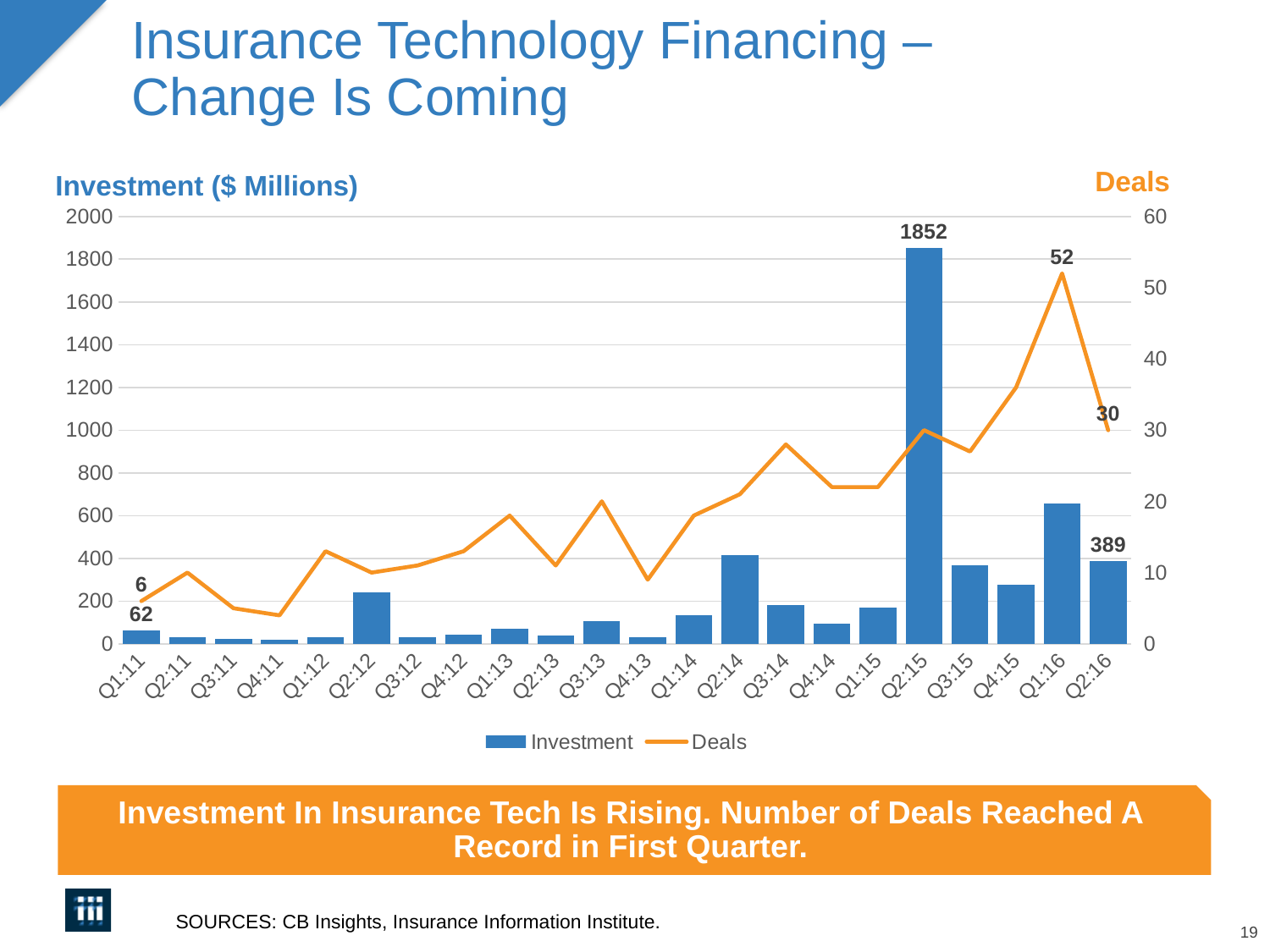
What is the Investment value for Q2:15? 1852 How many series does the legend list? 2 How many Deals are shown for Q1:16? 52 What is the Investment value for Q1:11? 62 Which quarter has the highest Investment? Q2:15 What is the difference between the Investment values for Q2:15 and Q2:16? 1463 Which quarter has the larger Investment, Q1:16 or Q2:16? Q1:16 Is the Investment value for Q2:12 greater or less than 200? greater How many quarters are shown on the x axis? 22 What is the Investment value for Q2:16? 389 By how much did the number of Deals fall from Q1:16 to Q2:16? 22 What is the Deals value for Q2:16? 30